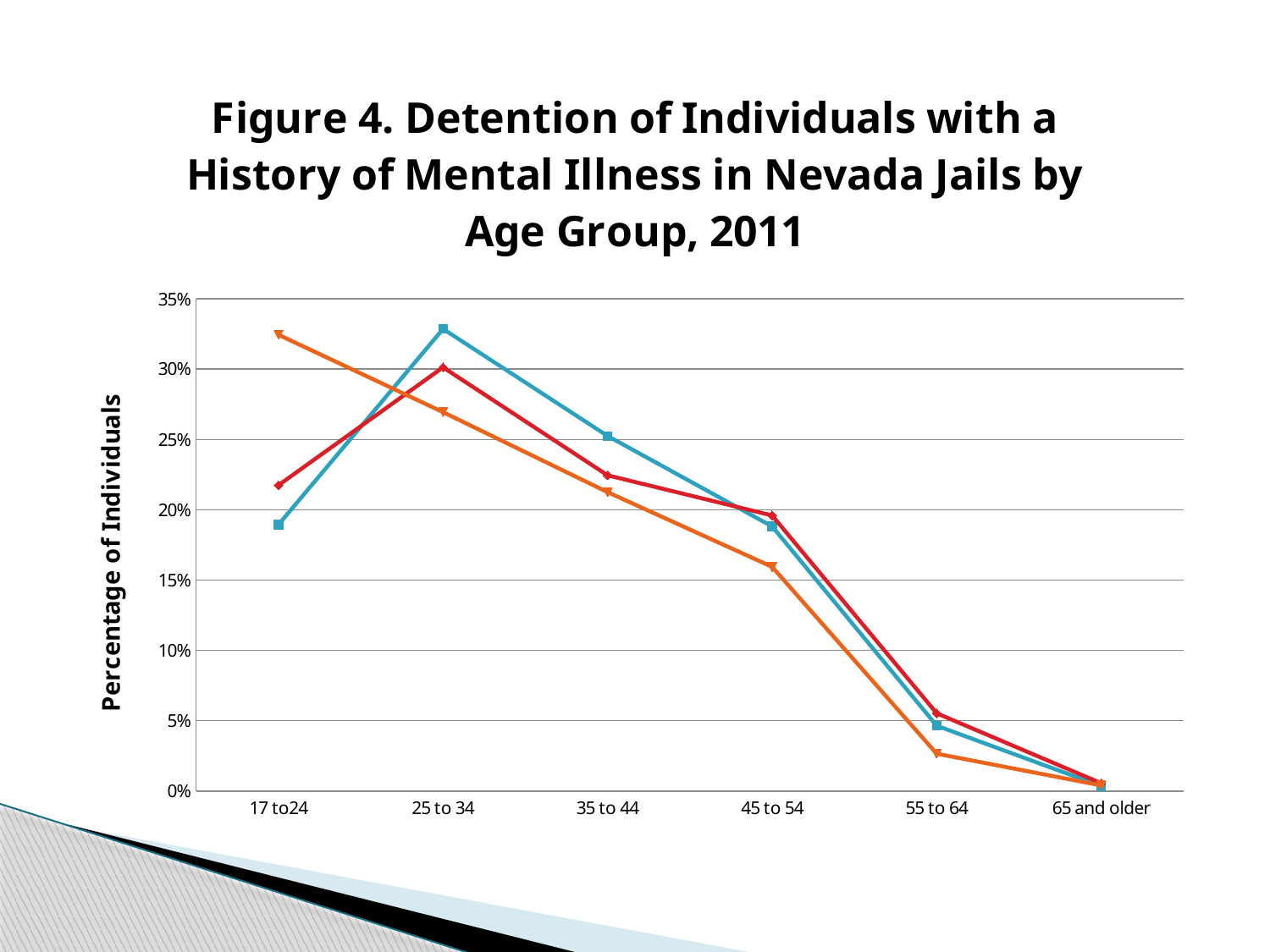
For the orange line with triangle markers, which age group has the highest value? 17 to24 How many age groups are shown on the x axis? 6 Is the value of the red line at 35 to 44 greater or less than 25%? less How many lines are plotted on the chart? 3 For the red line with diamond markers, which age group has the lowest value? 65 and older At 17 to24, which line has the higher value, the orange line or the blue line? the orange line Is the value of the orange line at 45 to 54 greater or less than 20%? less From 25 to 34 through 65 and older, do the values of the blue line rise or fall? fall What is the title of the y axis? Percentage of Individuals For the blue line with square markers, which age group has the highest value? 25 to 34 What kind of chart is shown on the slide? line chart Is the value of the blue line at 25 to 34 greater or less than 30%? greater